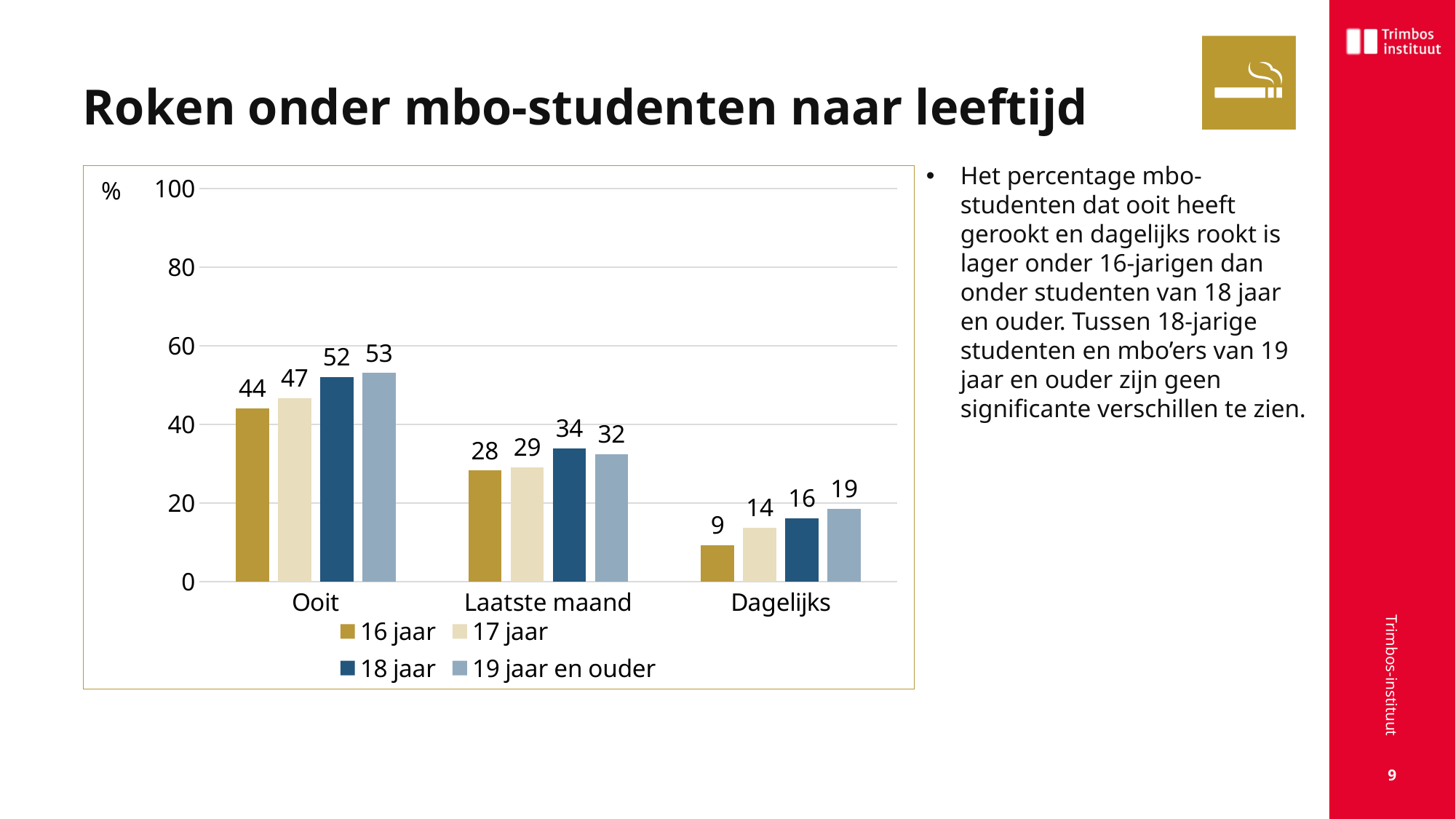
How many categories are shown on the x axis? 3 How many series does the legend list? 4 What is the difference between the 18 jaar and 16 jaar values in the Laatste maand category? 6 What is the value for 19 jaar en ouder in the Laatste maand category? 32 What is the value for 18 jaar in the Dagelijks category? 16 Which age group has the lowest value in the Dagelijks category? 16 jaar Which age group has the highest value in the Ooit category? 19 jaar en ouder What kind of chart is shown on the slide? Bar chart Is the value for 18 jaar in the Ooit category greater or less than 40? greater Which is larger in the Dagelijks category: the value for 17 jaar or the value for 19 jaar en ouder? 19 jaar en ouder What is the title of the slide containing the chart? Roken onder mbo-studenten naar leeftijd What is the value for 16 jaar in the Ooit category? 44